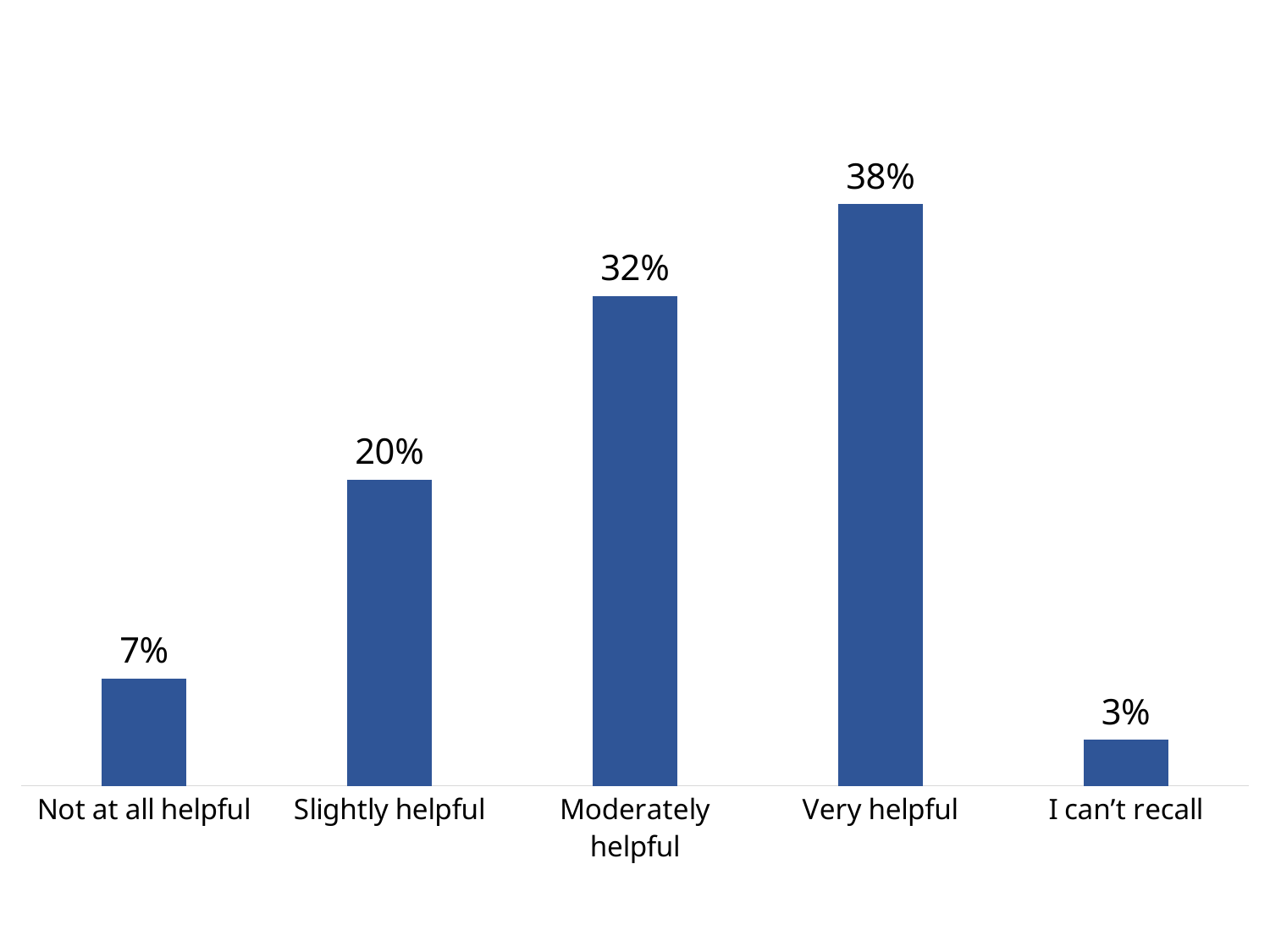
What is the value for Very helpful? 38% What is the value for I can't recall? 3% Which category has the lowest value? I can't recall What is the value for Moderately helpful? 32% Which is larger, the value for Slightly helpful or the value for Moderately helpful? Moderately helpful What kind of chart is shown on the slide? Bar chart Which category has the highest value? Very helpful What is the difference between the values for Very helpful and Moderately helpful? 6% What colour are the bars on the chart? Blue How many categories are shown on the chart? 5 What is the difference between the values for Slightly helpful and Not at all helpful? 13% What is the value for Not at all helpful? 7%